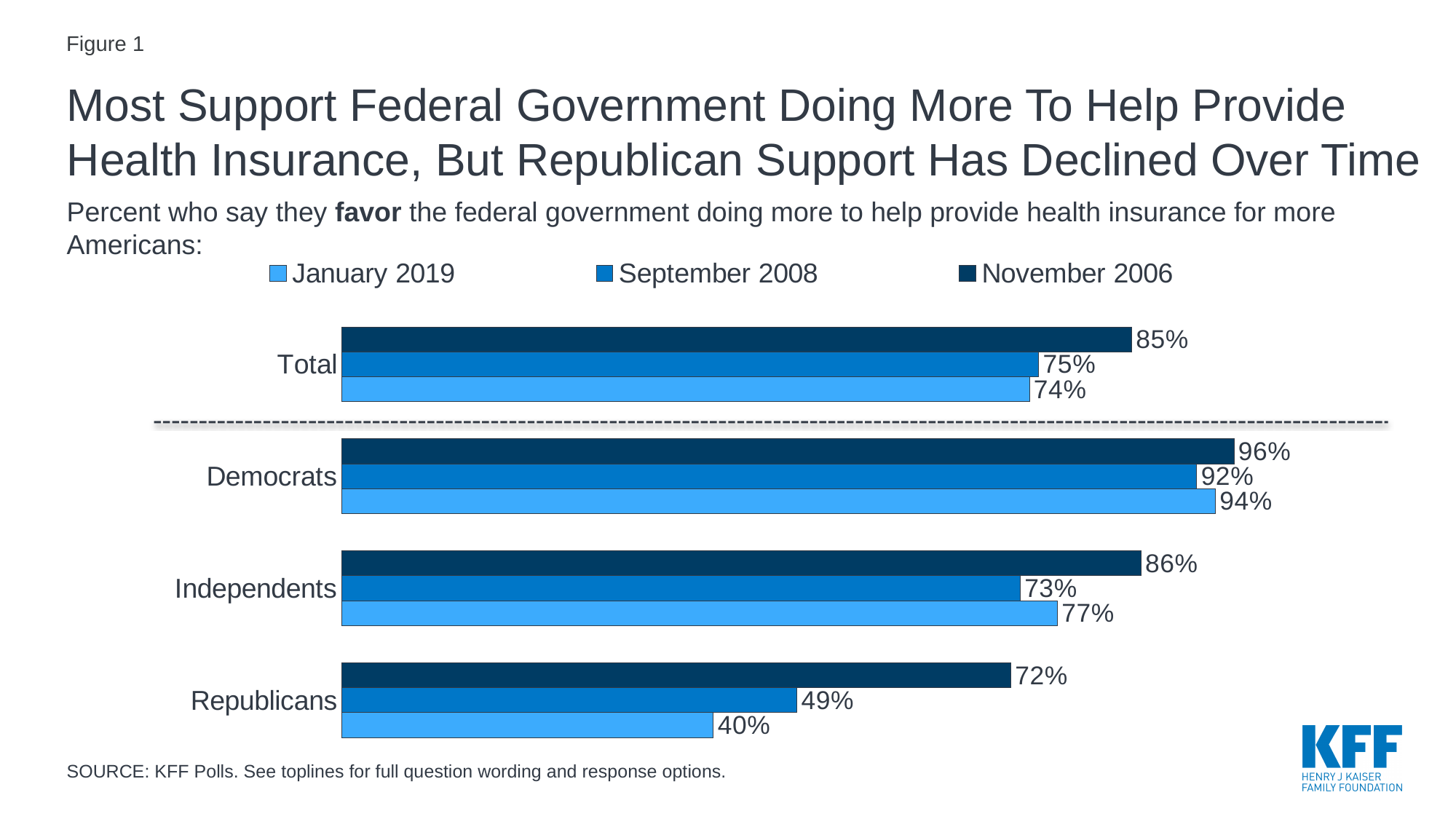
How many series does the legend list? 3 What was the value for Independents in September 2008? 73% Which is larger for Democrats: the September 2008 value or the January 2019 value? January 2019 What percent of Republicans said they favor the federal government doing more to help provide health insurance in January 2019? 40% Which group had the highest value in January 2019? Democrats Which group had the lowest value in November 2006? Republicans What is the difference between the Independents' values in November 2006 and January 2019? 9 What kind of chart is shown on the slide? Bar chart How many groups are shown on the chart? 4 What was the value for Democrats in November 2006? 96% What was the Total value in January 2019? 74% By how many percentage points did Republican support fall from November 2006 to January 2019? 32